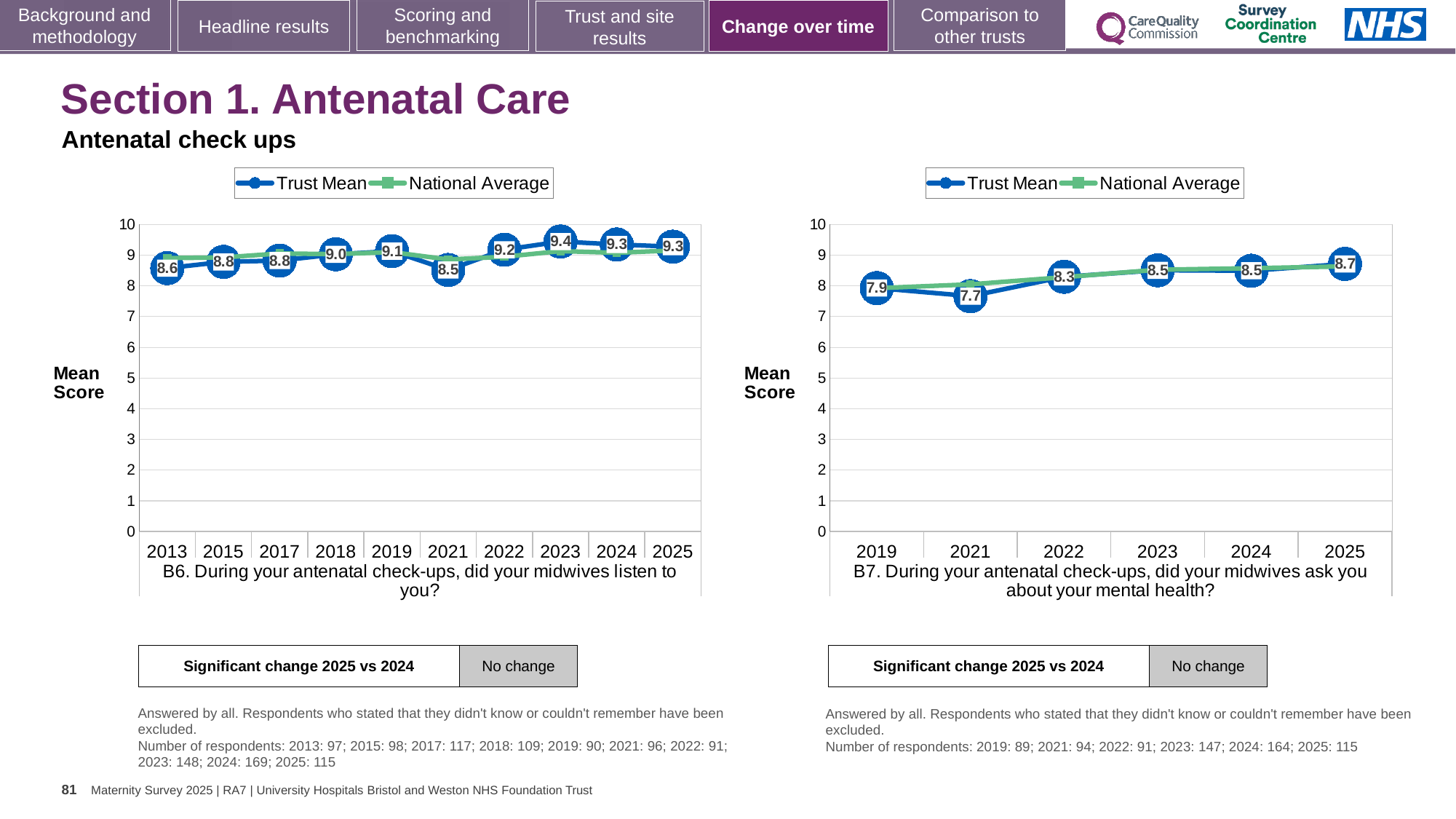
In the B6 chart (left), what is the difference between the Trust Mean in 2023 and in 2013? 0.8 What kind of chart is the B7 chart (right)? Line chart In the B6 chart (left), what is the Trust Mean for 2021? 8.5 In the B7 chart (right), how many series does the legend list? 2 In the B6 chart (left), what is the Trust Mean for 2025? 9.3 In the B6 chart (left), which year has the highest Trust Mean? 2023 In the B7 chart (right), is the Trust Mean for 2021 greater or less than 8? less In the B7 chart (right), which year has the highest Trust Mean? 2025 In the B6 chart (left), which year has the lowest Trust Mean? 2021 In the B6 chart (left), how many years are shown on the x axis? 10 In the B7 chart (right), what is the difference between the Trust Mean in 2025 and in 2019? 0.8 In the B7 chart (right), what is the Trust Mean for 2021? 7.7